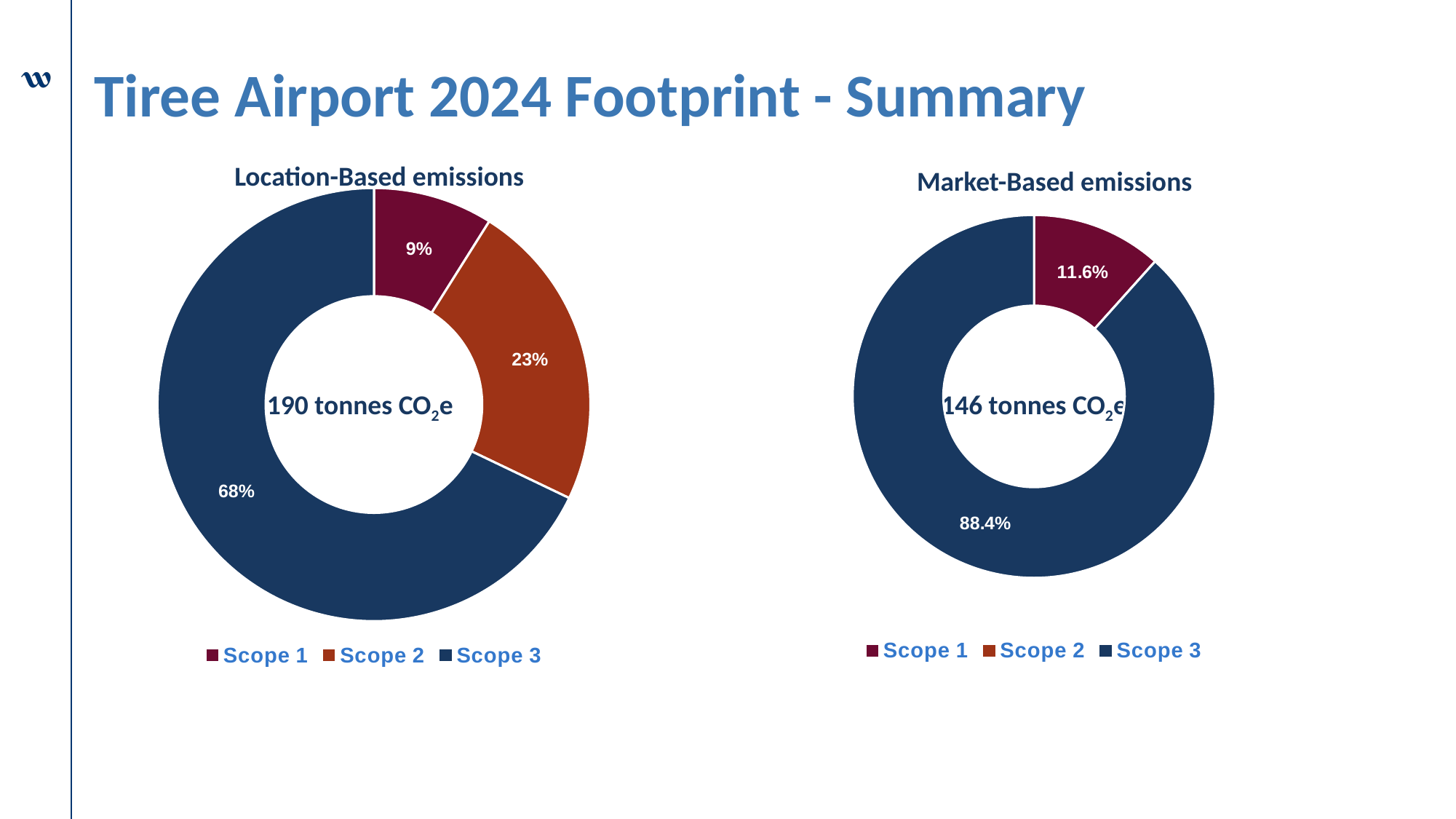
In the Location-Based emissions chart, what share of emissions is Scope 1? 9% In the Location-Based emissions chart, what is the difference in percentage points between Scope 2 and Scope 1? 14 percentage points In the Location-Based emissions chart, what share of emissions is Scope 3? 68% In the Location-Based emissions chart, which scope has the largest share? Scope 3 In the Location-Based emissions chart, which scope has the smallest share? Scope 1 What type of chart is the Location-Based emissions chart? Doughnut chart In the Location-Based emissions chart, what share of emissions is Scope 2? 23% In the Market-Based emissions chart, what share of emissions is Scope 1? 11.6% What total is shown in the centre of the Market-Based emissions chart? 146 tonnes CO2e How many entries does the legend of the Market-Based emissions chart list? 3 In the Market-Based emissions chart, which is larger, Scope 1 or Scope 3? Scope 3 In the Market-Based emissions chart, what share of emissions is Scope 3? 88.4%